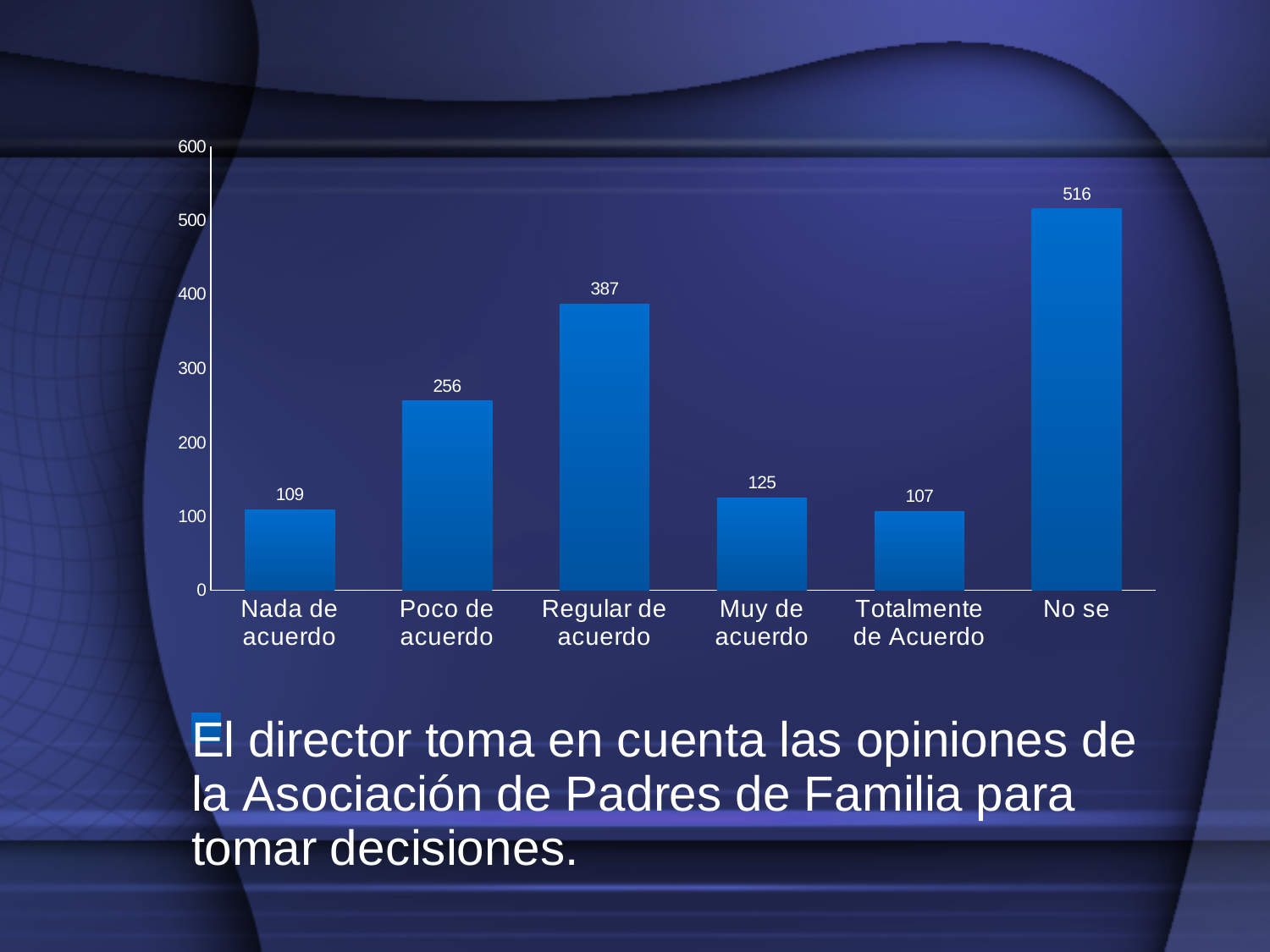
What kind of chart is shown on the slide? Bar chart What is the highest value shown on the vertical axis? 600 What is the difference between the values for "No se" and "Regular de acuerdo"? 129 What is the value for "Totalmente de Acuerdo"? 107 Which category has the highest value? No se Which is larger, the value for "Muy de acuerdo" or the value for "Poco de acuerdo"? Poco de acuerdo Which category has the lowest value? Totalmente de Acuerdo What is the value for "No se"? 516 Is the value for "Regular de acuerdo" greater or less than 300? greater What is the value for "Regular de acuerdo"? 387 How many categories are shown on the x axis? 6 What is the difference between the values for "Poco de acuerdo" and "Nada de acuerdo"? 147